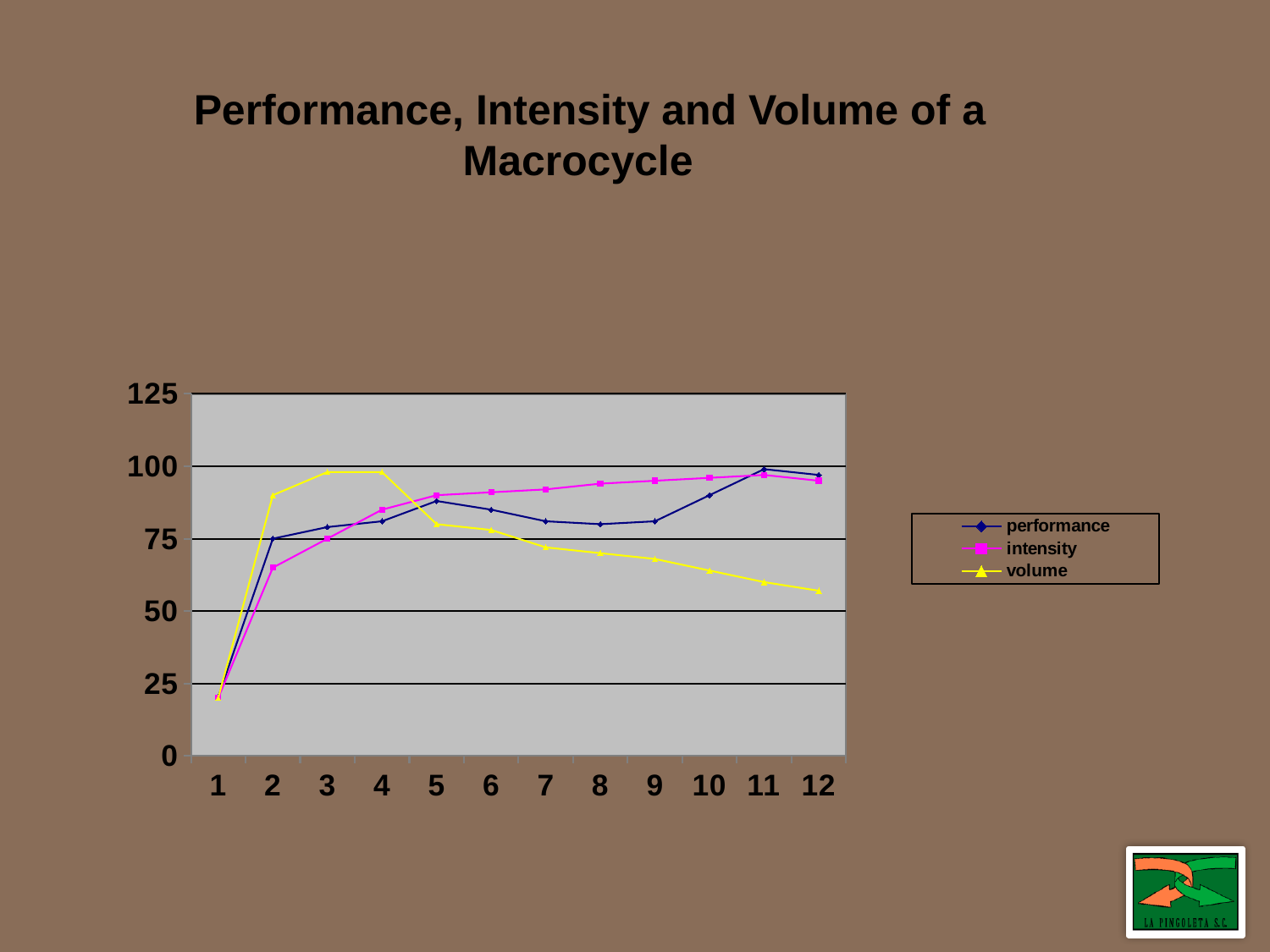
Is the value for volume at point 12 greater or less than 75? less Which series has the highest value at point 4? volume What kind of chart is shown on the slide? line chart At point 2, which is larger: volume or intensity? volume What is the title of the chart? Performance, Intensity and Volume of a Macrocycle How many series does the legend list? 3 Is the value for performance at point 1 greater or less than 25? less How many points are plotted along the x axis for each series? 12 Is the value for intensity at point 2 greater or less than 75? less Which colour is used for the volume series? yellow Which series has the lowest value at point 12? volume